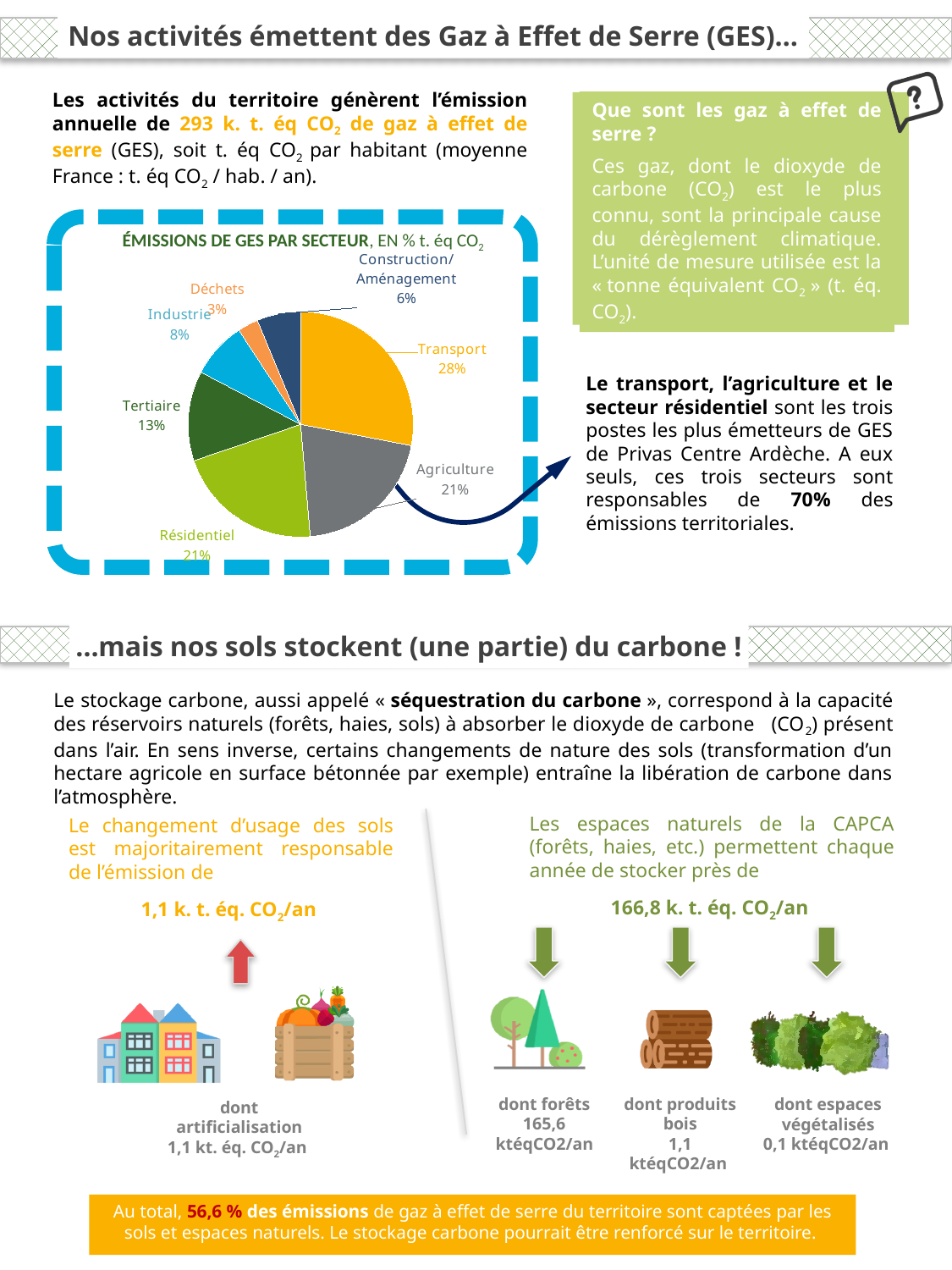
What is the title of the pie chart? ÉMISSIONS DE GES PAR SECTEUR, EN % t. éq CO2 Which sector has the largest share in the pie chart? Transport What is the share of Tertiaire in the pie chart? 13% What is the share of Agriculture in the pie chart? 21% How many sectors are shown in the pie chart? 7 Which sector has the smallest share in the pie chart? Déchets What is the share of Construction/Aménagement in the pie chart? 6% What type of chart is shown on the slide? pie chart Which is larger in the pie chart, Industrie or Déchets? Industrie What is the share of Industrie in the pie chart? 8% What is the difference between the shares of Transport and Tertiaire in the pie chart? 15% What is the share of Transport in the pie chart? 28%